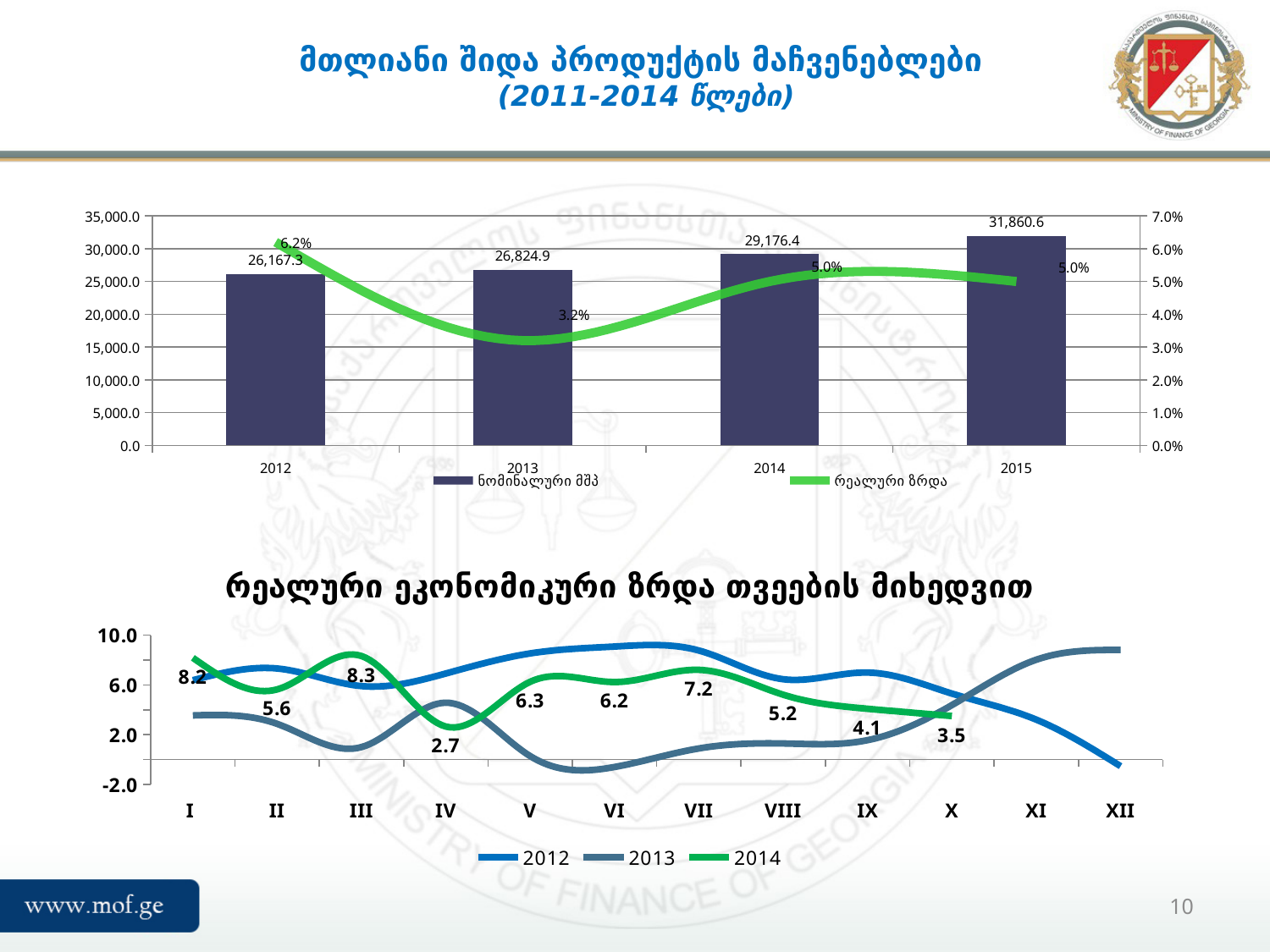
In the top chart, which year has the highest nominal GDP bar? 2015 In the bottom chart, what is the value for the 2014 series in month IV? 2.7 In the top chart, how many series does the legend list? 2 In the top chart, how many years are shown on the x axis? 4 In the top chart, which year has the lowest real growth rate? 2013 In the top chart, is the real growth rate for 2012 higher or lower than for 2014? higher In the top chart, what is the difference between the nominal GDP values for 2014 and 2013? 2,351.5 In the bottom chart, what is the value for the 2014 series in month III? 8.3 What kind of chart is the bottom chart? line chart In the bottom chart, how many series does the legend list? 3 In the top chart, what is the nominal GDP value for 2015? 31,860.6 In the top chart, what is the real growth rate shown for 2013? 3.2%